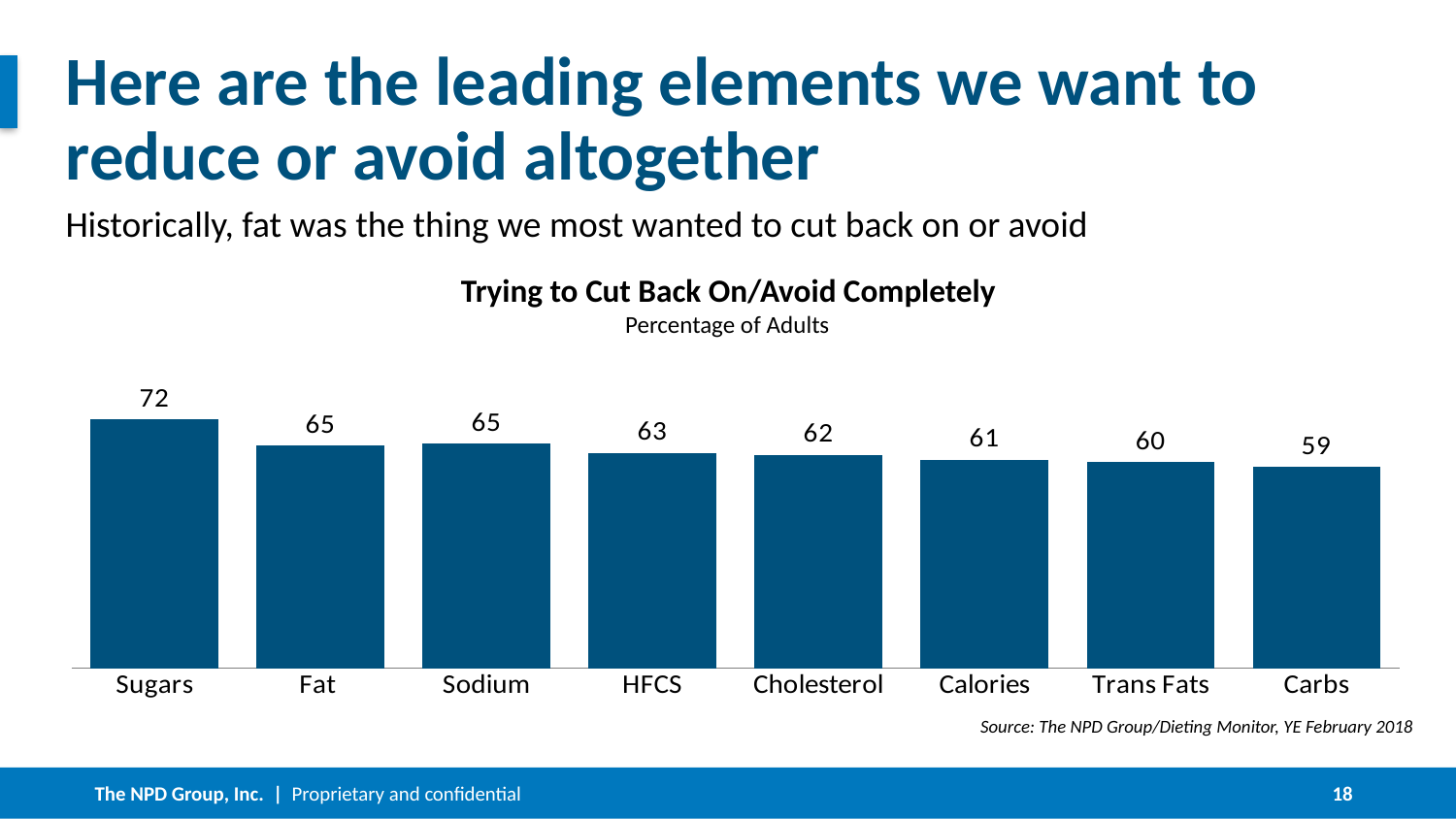
What is the value for Carbs? 59 What is the title of the chart? Trying to Cut Back On/Avoid Completely What is the value for Cholesterol? 62 Which category has the lowest value? Carbs Which is larger, the value for Sugars or the value for Calories? Sugars What is the value for Sugars? 72 What is the difference between the values for HFCS and Carbs? 4 Do the values rise or fall from left to right along the x axis? Fall What is the difference between the values for Sugars and Fat? 7 Which category has the highest value? Sugars How many categories are shown in the chart? 8 What kind of chart is shown on the slide? Bar chart